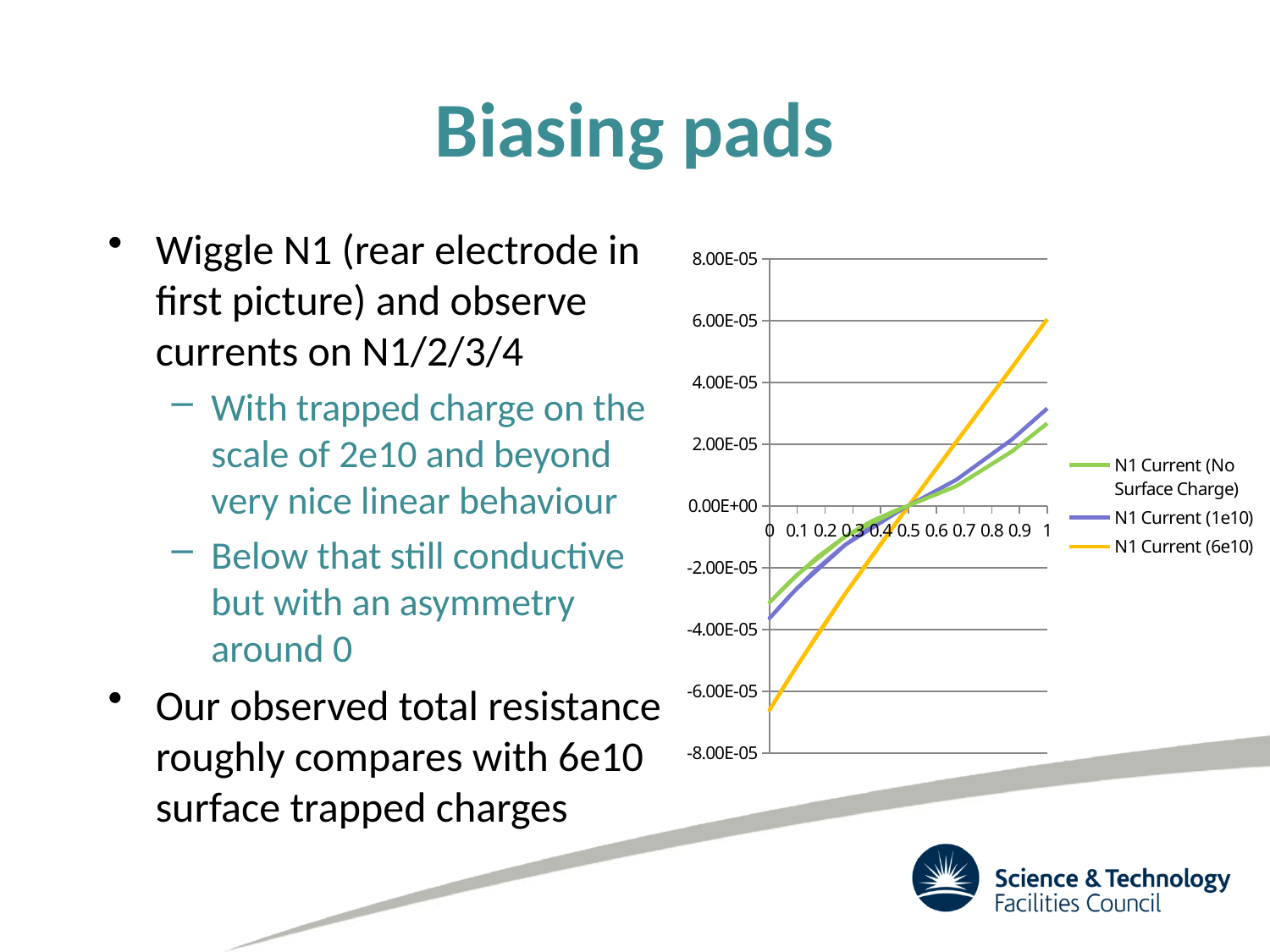
Which series has the highest value at x = 1? N1 Current (6e10) Which series has the lowest value at x = 0? N1 Current (6e10) Is the value of N1 Current (6e10) at x = 0 greater or less than -6.00E-05? less Which colour is used for the N1 Current (6e10) series? yellow How many series does the chart legend list? 3 What are the three series named in the chart legend? N1 Current (No Surface Charge), N1 Current (1e10), N1 Current (6e10) Is the value of N1 Current (6e10) at x = 1 greater or less than 4.00E-05? greater Is the value of N1 Current (No Surface Charge) at x = 1 greater or less than 2.00E-05? greater How many tick labels are shown on the x axis of the chart? 11 At x = 1, which is larger: N1 Current (6e10) or N1 Current (No Surface Charge)? N1 Current (6e10) What kind of chart is shown on the slide? line chart Do the values of the N1 Current (6e10) series rise or fall as x increases from 0 to 1? rise